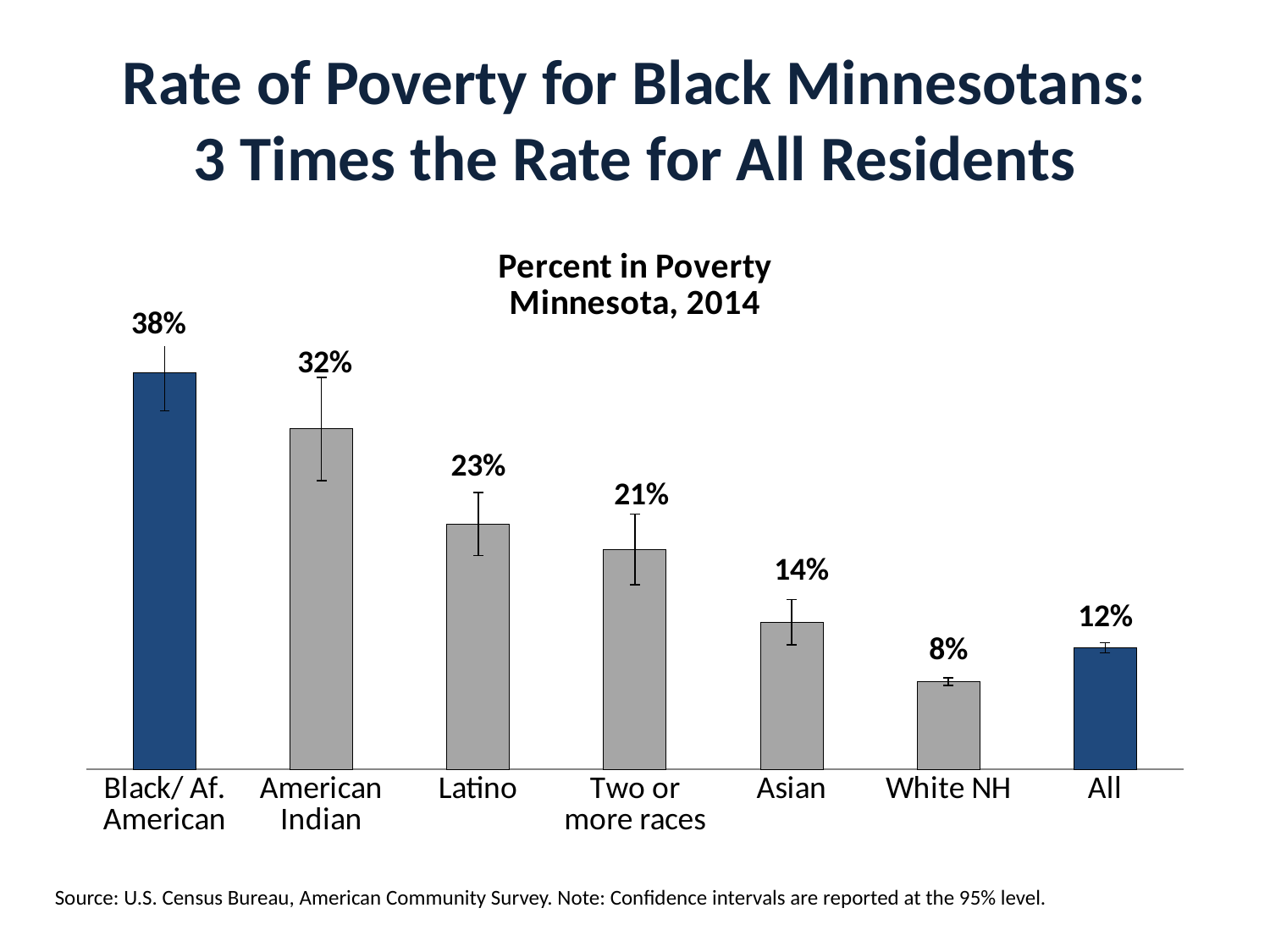
What is the title of the chart? Percent in Poverty Minnesota, 2014 What is the difference in percent in poverty between Black/ Af. American and All? 26% What is the percent in poverty for Asian? 14% How many categories are shown on the x axis of the chart? 7 What is the percent in poverty for Black/ Af. American Minnesotans? 38% What is the percent in poverty for White NH? 8% Which category has the highest percent in poverty? Black/ Af. American Which has a higher percent in poverty, Two or more races or Asian? Two or more races What kind of chart is shown on the slide? Bar chart What is the percent in poverty for the All category? 12% What is the difference in percent in poverty between American Indian and Latino? 9% Which category has the lowest percent in poverty? White NH